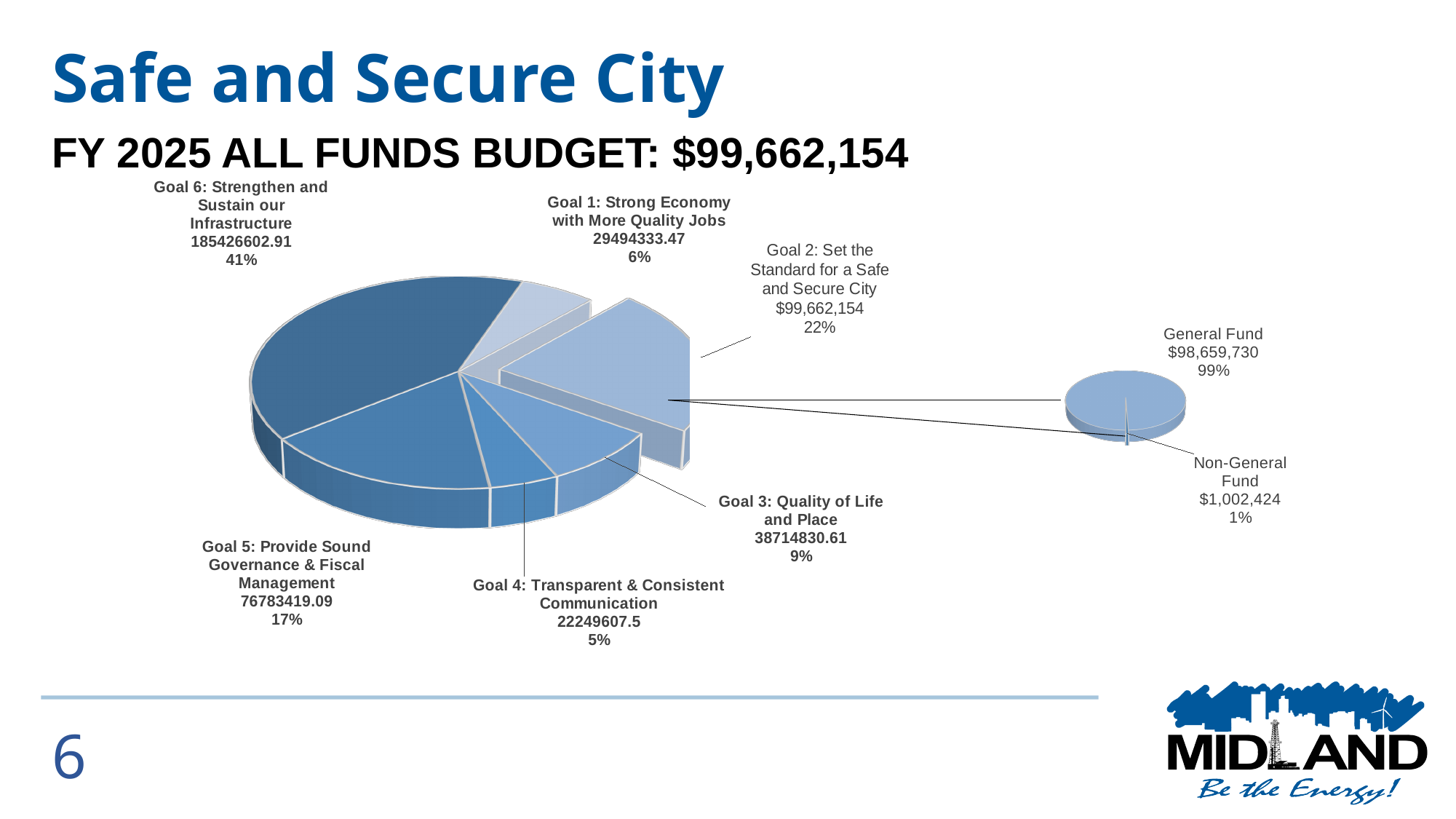
What percentage of the main pie does Goal 2: Set the Standard for a Safe and Secure City represent? 22% What is the difference between the values for Goal 6 and Goal 5? 108643183.82 How many goals are shown as slices in the main pie? 6 What is the value shown for Goal 3: Quality of Life and Place? 38714830.61 Which is larger, the value for Goal 5: Provide Sound Governance & Fiscal Management or Goal 1: Strong Economy with More Quality Jobs? Goal 5: Provide Sound Governance & Fiscal Management What is the value shown for Goal 6: Strengthen and Sustain our Infrastructure? 185426602.91 Which goal has the largest share of the main pie? Goal 6: Strengthen and Sustain our Infrastructure Which goal has the smallest share of the main pie? Goal 4: Transparent & Consistent Communication What percentage does the Non-General Fund represent in the secondary pie? 1% What is the value shown for the General Fund in the secondary pie? $98,659,730 What is the difference between the General Fund and Non-General Fund values? $97,657,306 What kind of chart is shown on the slide? Pie chart